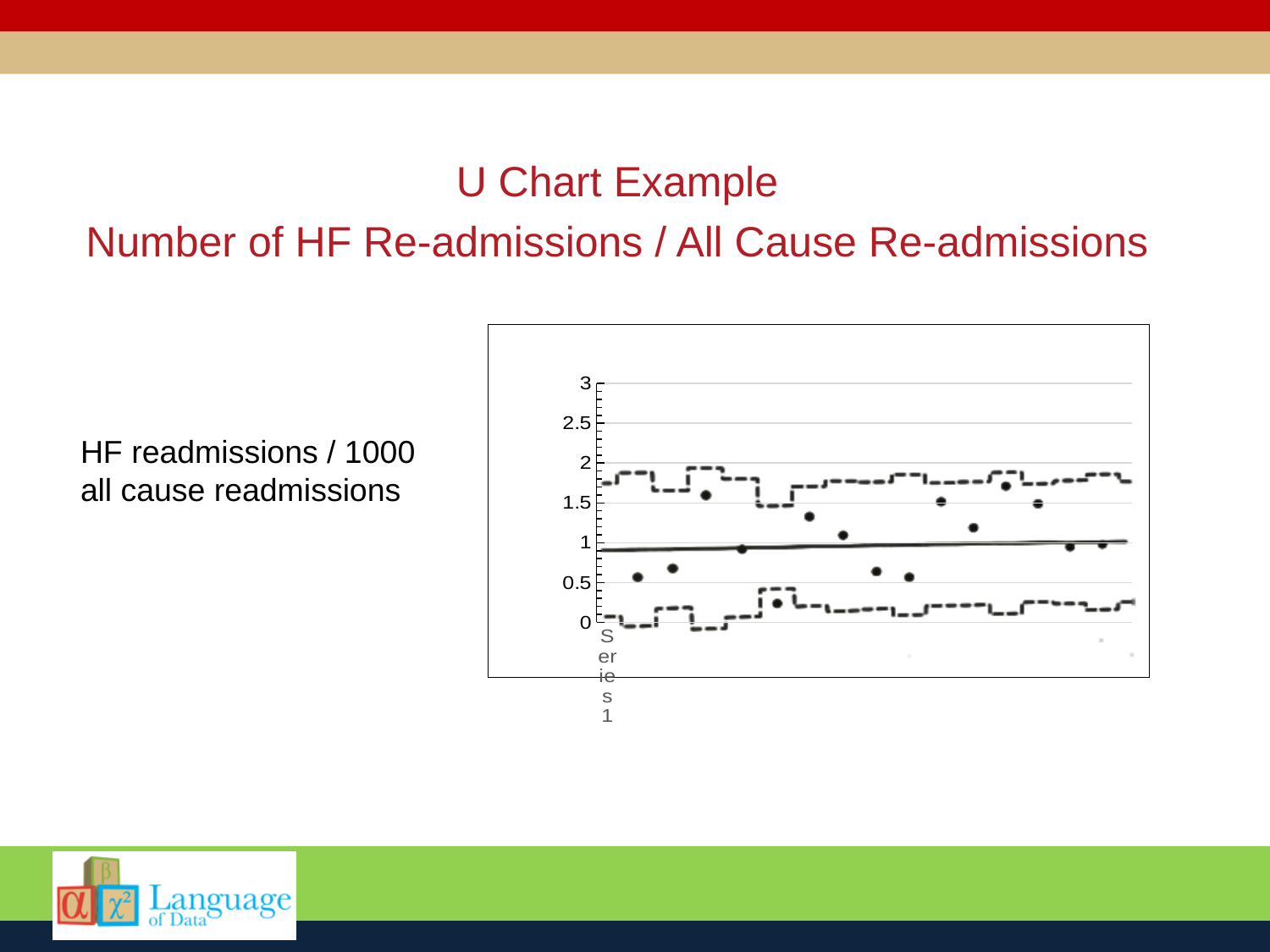
Is the solid centre line on the chart greater or less than 1.5? less Is the highest plotted data point greater or less than 1.5? greater Which is larger, the first (leftmost) plotted data point or the last (rightmost) plotted data point? the last (rightmost) point How many data points are plotted on the chart? 15 What is the highest value shown on the chart's vertical axis? 3 Is the last plotted data point (rightmost) greater or less than 1.5? less What is the title shown above the chart on the slide? U Chart Example Number of HF Re-admissions / All Cause Re-admissions What is the interval between the tick labels on the chart's vertical axis? 0.5